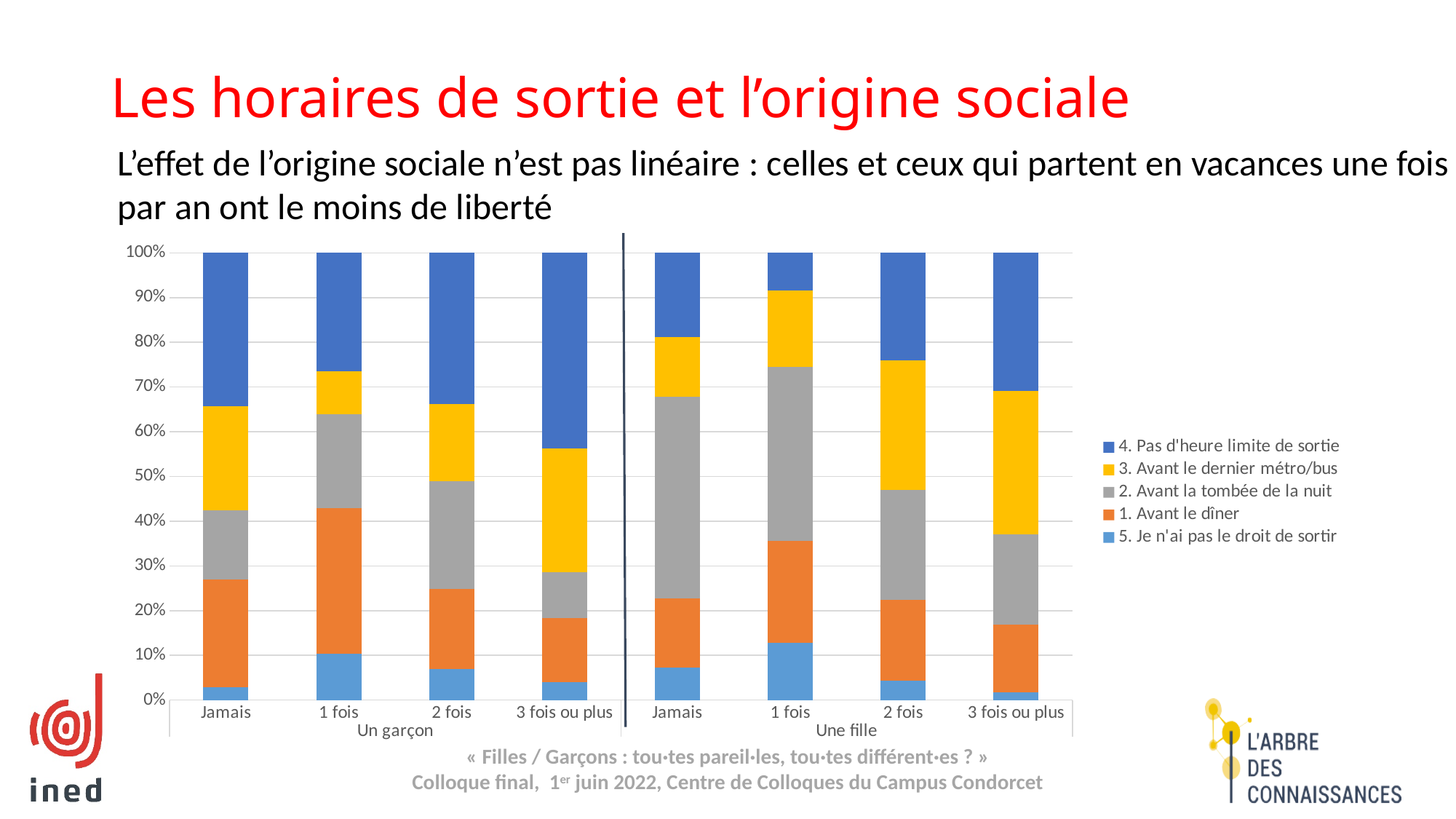
Is the share of '1. Avant le dîner' for '1 fois' in the 'Un garçon' group greater or less than 30%? greater Which colour represents '3. Avant le dernier métro/bus' in the legend? Yellow Is the share of '4. Pas d'heure limite de sortie' for '1 fois' in the 'Une fille' group greater or less than 10%? less How many bars are plotted in the chart? 8 In the 'Un garçon' group, is the share of '4. Pas d'heure limite de sortie' larger for '3 fois ou plus' or for '1 fois'? 3 fois ou plus What kind of chart is shown on the slide? Stacked bar chart Is the share of '5. Je n'ai pas le droit de sortir' for '1 fois' in the 'Une fille' group greater or less than 10%? greater Within the 'Un garçon' group, which category has the largest share of '5. Je n'ai pas le droit de sortir'? 1 fois What are the two groups into which the bars are divided along the x axis? Un garçon and Une fille What does each stacked bar total? 100% Within the 'Une fille' group, which category has the smallest share of '5. Je n'ai pas le droit de sortir'? 3 fois ou plus How many series does the legend list? 5